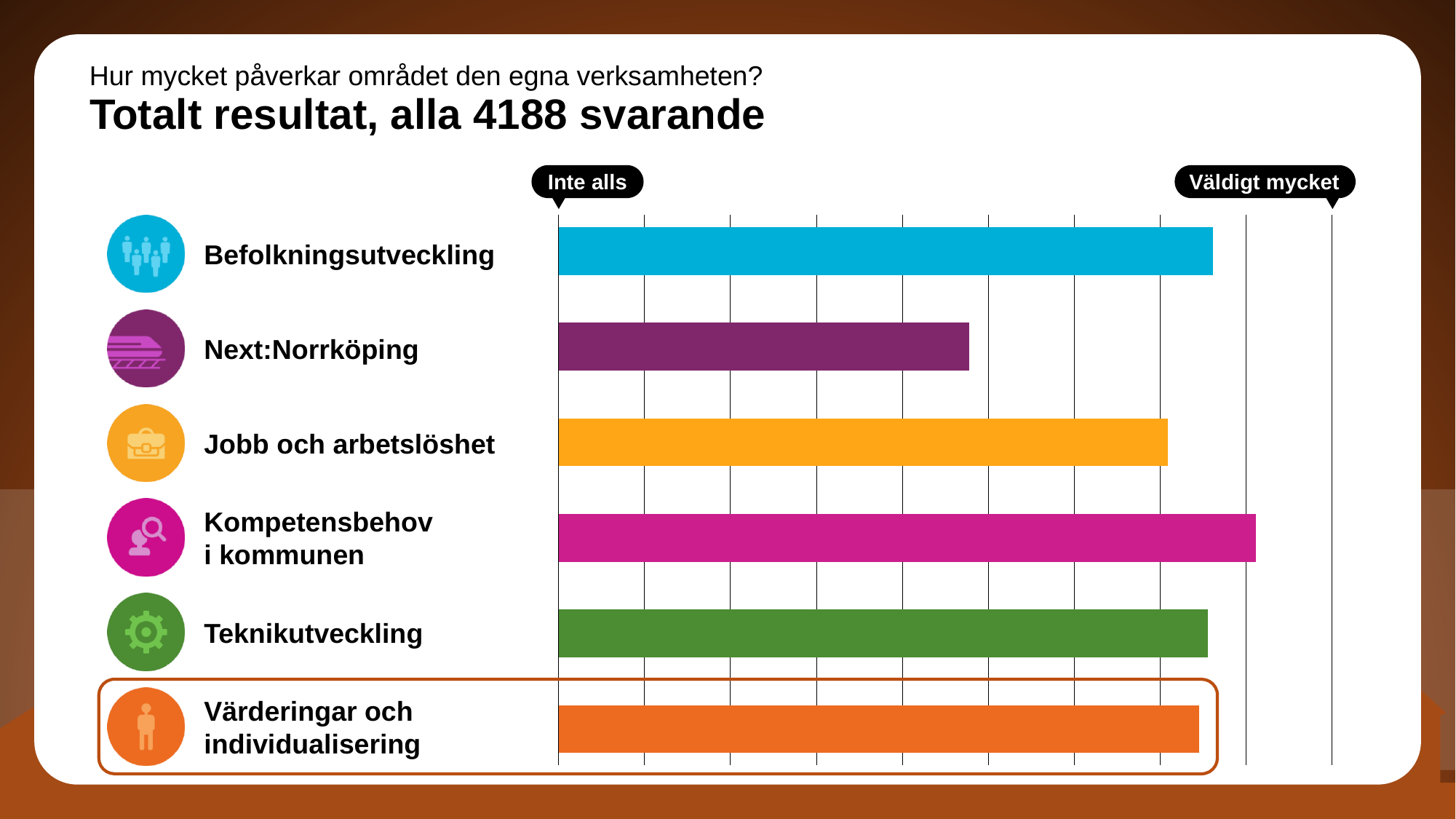
Which category is highlighted with an orange outline on the slide? Värderingar och individualisering What kind of chart is shown on the slide? bar chart How many categories (areas) are shown in the chart? 6 Which category has the shortest bar? Next:Norrköping Which bar is longer, Kompetensbehov i kommunen or Teknikutveckling? Kompetensbehov i kommunen Which bar is longer, Next:Norrköping or Jobb och arbetslöshet? Jobb och arbetslöshet What label marks the left end of the chart's scale? Inte alls Which bar is longer, Befolkningsutveckling or Jobb och arbetslöshet? Befolkningsutveckling Which category has the longest bar? Kompetensbehov i kommunen